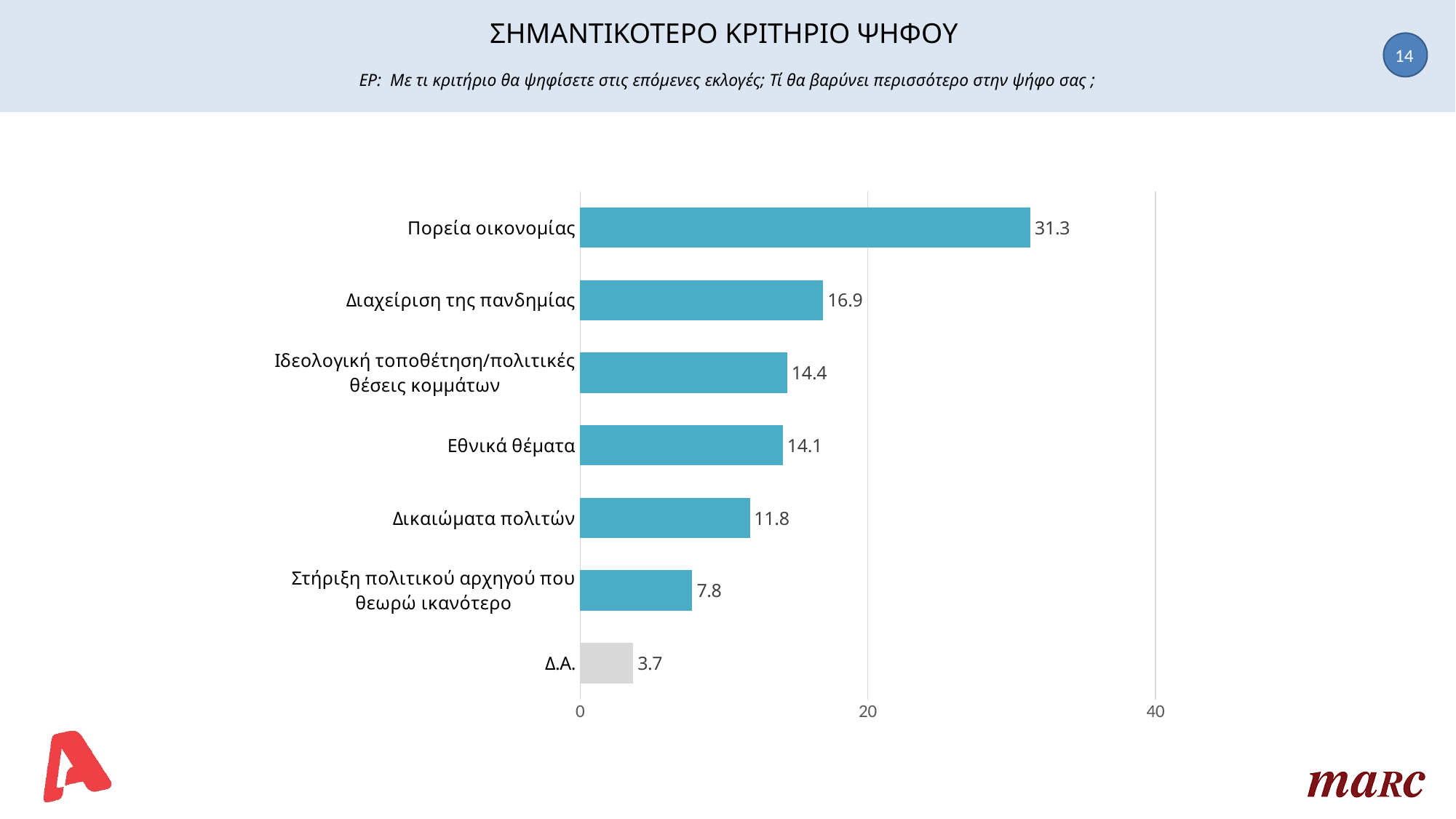
What is the value for Δ.Α.? 3.7 What is the difference between the values for Πορεία οικονομίας and Διαχείριση της πανδημίας? 14.4 What kind of chart is shown on the slide? bar chart Is the value for Πορεία οικονομίας greater or less than 20? greater How many categories are shown in the chart? 7 What is the title of the slide? ΣΗΜΑΝΤΙΚΟΤΕΡΟ ΚΡΙΤΗΡΙΟ ΨΗΦΟΥ What is the value for Πορεία οικονομίας? 31.3 Which category has the highest value? Πορεία οικονομίας Which is larger, the value for Εθνικά θέματα or the value for Δικαιώματα πολιτών? Εθνικά θέματα What is the value for Δικαιώματα πολιτών? 11.8 Which category has the lowest value? Δ.Α. What is the value for Διαχείριση της πανδημίας? 16.9